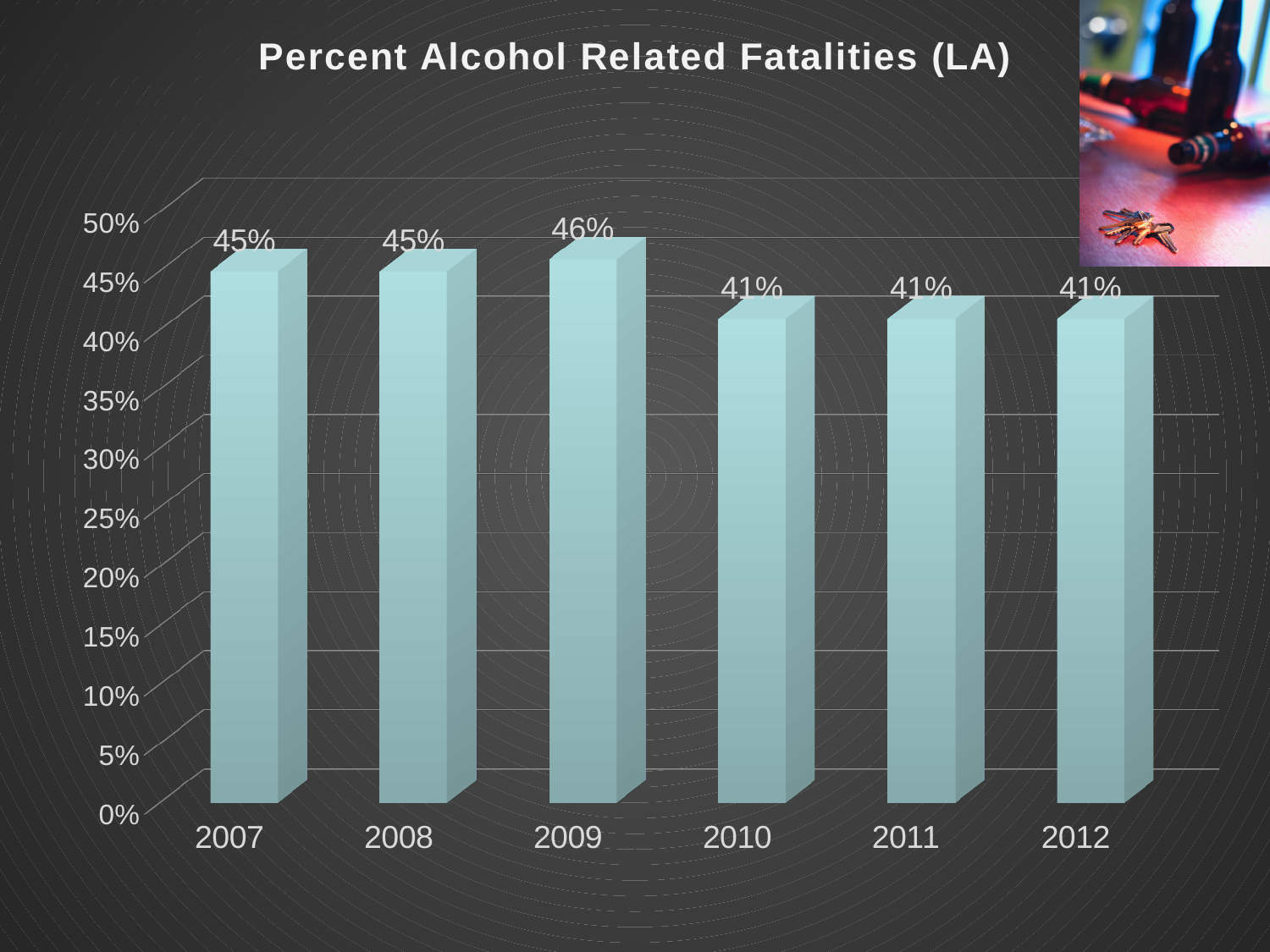
Which year has the highest percent of alcohol related fatalities? 2009 How many years are shown on the x axis? 6 What kind of chart is shown on the slide? bar chart Is the value for 2010 greater or less than 45%? less What is the value for 2007? 45% What is the value for 2011? 41% Do the values rise or fall from 2009 to 2012? fall Which is larger, the value for 2008 or the value for 2011? 2008 What is the title of the chart? Percent Alcohol Related Fatalities (LA) What is the difference between the values for 2009 and 2010? 5% What is the difference between the values for 2007 and 2012? 4% What is the value for 2009? 46%